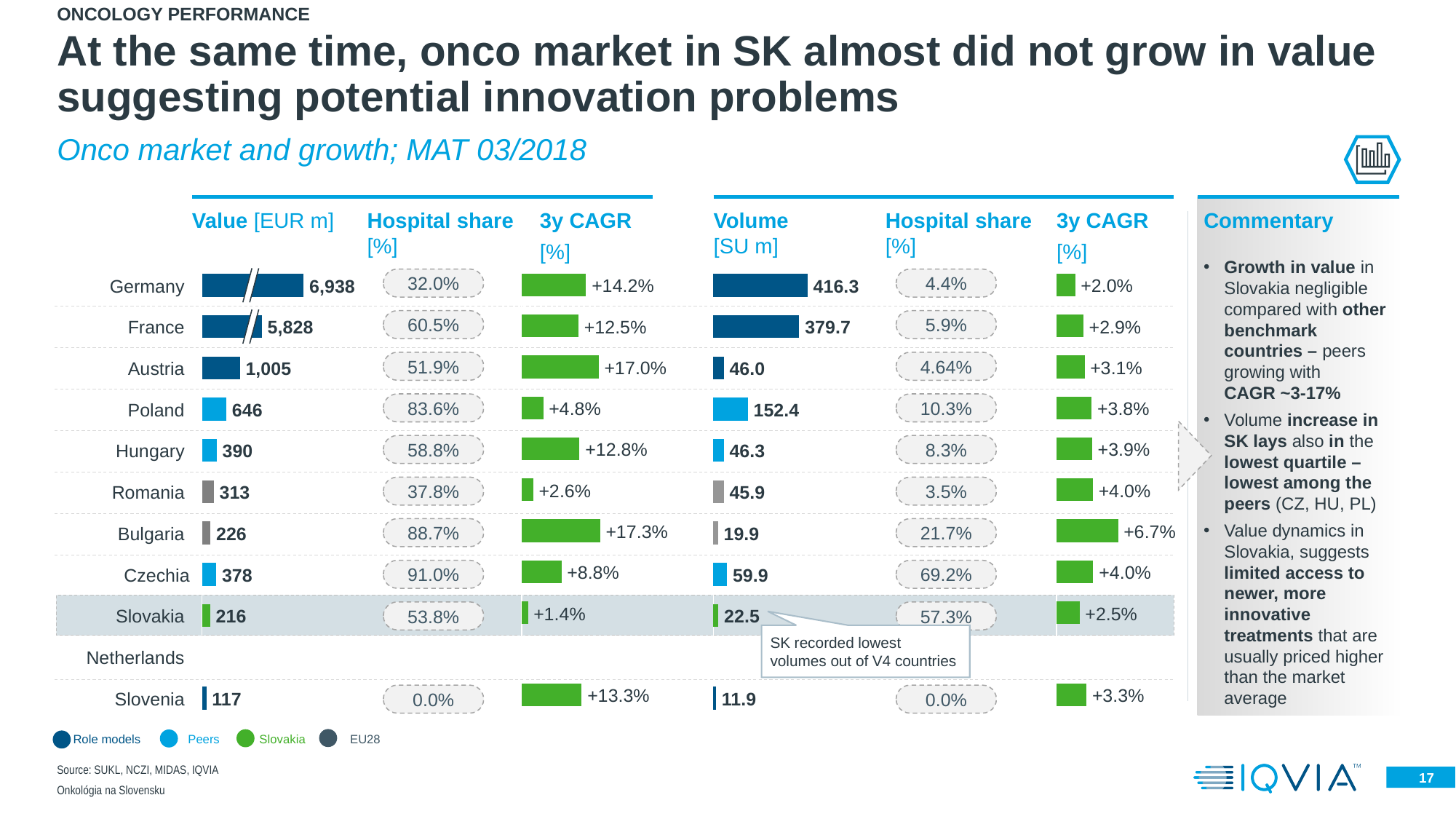
In the 3y CAGR [%] chart next to Value, which country has the highest growth? Bulgaria What kind of chart is the Value [EUR m] chart? Bar chart In the Volume [SU m] chart, what is the value for Poland? 152.4 In the Volume [SU m] chart, which country has the highest volume? Germany How many entries does the legend at the bottom of the slide list? 4 In the Value [EUR m] chart, which country has the lowest value? Slovenia In the Value [EUR m] chart, what is the difference between Germany and France? 1,110 In the 3y CAGR [%] chart next to Value, what is the growth for Slovakia? +1.4% In the 3y CAGR [%] chart next to Volume, what is the growth for Bulgaria? +6.7% In the Value [EUR m] chart, what is the value for Germany? 6,938 In the Value [EUR m] chart, what is the value for Slovakia? 216 In the Volume [SU m] chart, which is larger, Czechia or Hungary? Czechia